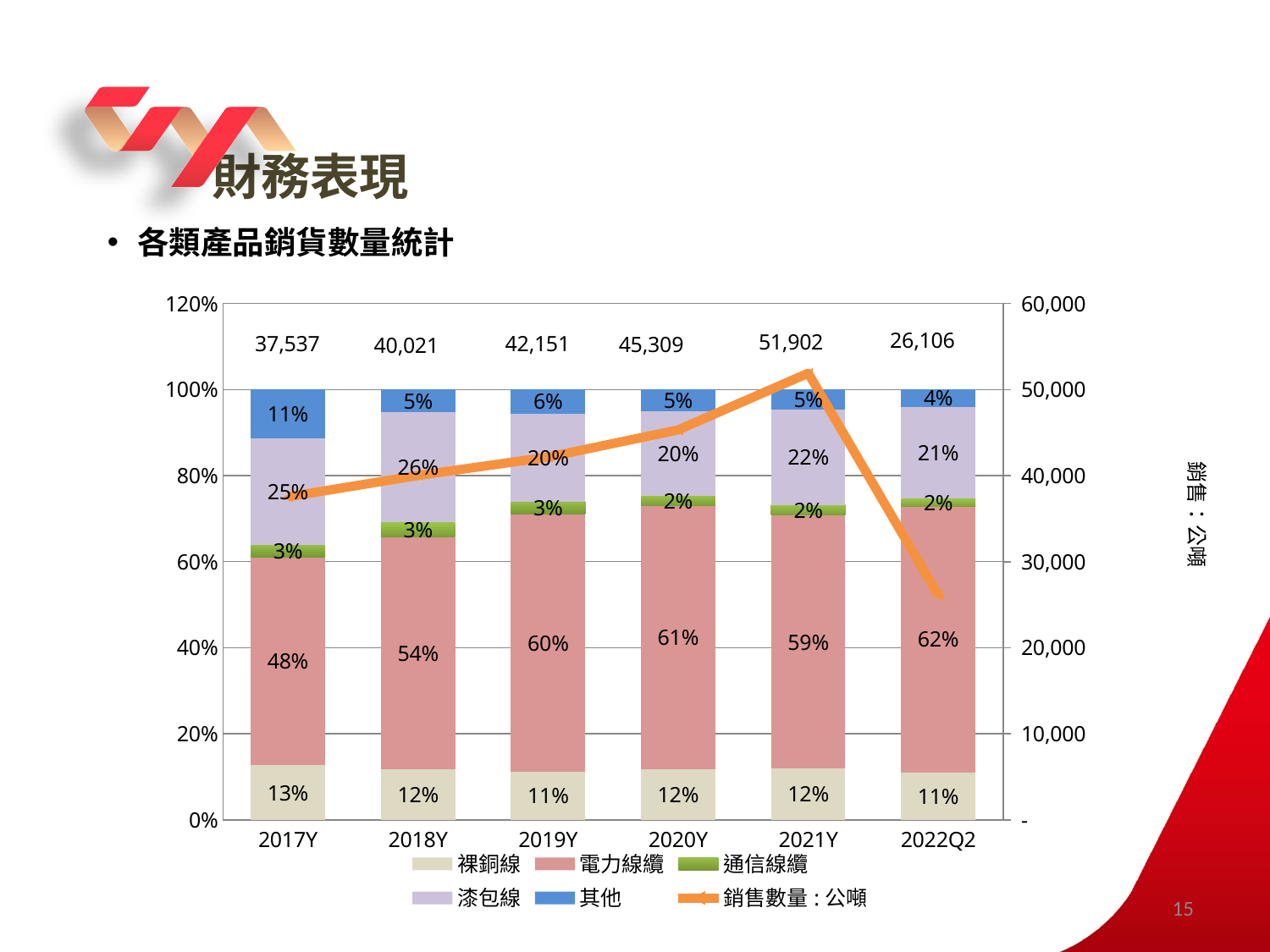
What is the share of 其他 in 2017Y? 11% Which is larger, the 電力線纜 share in 2017Y or in 2022Q2? 2022Q2 What is the difference between the 銷售數量 values for 2021Y and 2020Y? 6,593 Which period has the lowest 銷售數量 (公噸) value? 2022Q2 What kind of chart is shown on the slide? Stacked bar chart with a line What is the share of 電力線纜 in 2019Y? 60% How many periods are shown on the x axis? 6 What is the share of 漆包線 in 2018Y? 26% Which year has the highest 銷售數量 (公噸) value? 2021Y What is the 銷售數量 (公噸) value shown for 2021Y? 51,902 How many series does the legend list? 6 Does the 銷售數量 line rise or fall from 2017Y to 2021Y? Rise